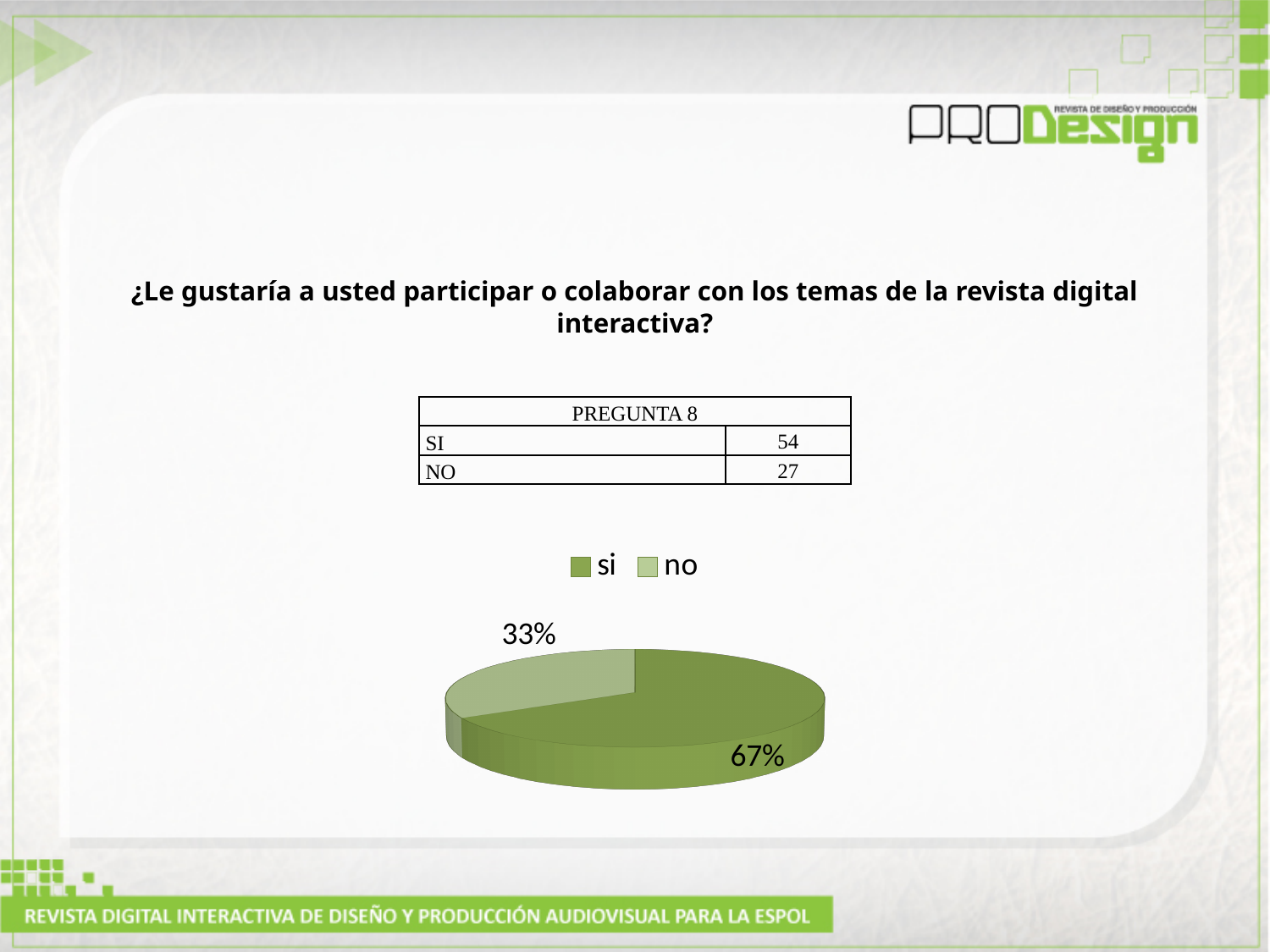
What are the two legend entries of the pie chart? si, no What share of the pie does the "si" slice take? 67% Which slice of the pie is the smallest? no What kind of chart is shown on the slide? pie chart Which is larger, the "si" slice or the "no" slice? si What percentage of the pie is labelled for the "no" slice? 33% What percentage of the pie is labelled for the "si" slice? 67% What is the difference in percentage points between the "si" slice and the "no" slice? 34 How many slices does the pie chart have? 2 How many entries does the legend list? 2 Which slice of the pie is the largest? si Which legend entry is shown in the darker green colour? si